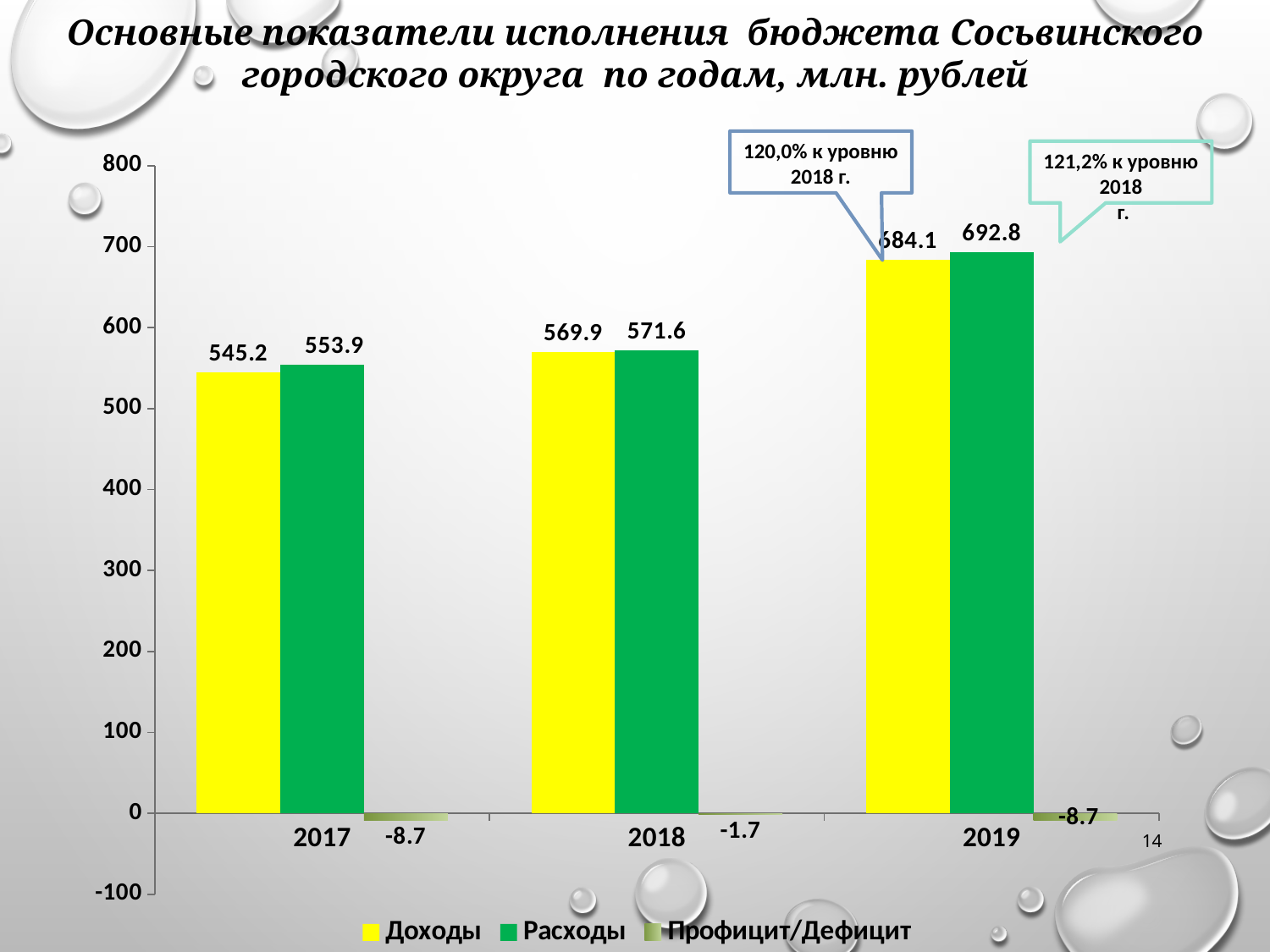
Is the value of Доходы for 2019 greater or less than 600? greater In which year is Расходы the highest? 2019 What is the value of Профицит/Дефицит for 2018? -1.7 Do the Расходы values rise or fall from 2017 to 2019? rise In 2018, which is larger: Доходы or Расходы? Расходы What is the value of Расходы for 2019? 692.8 How many series does the legend list? 3 What is the difference between Расходы and Доходы in 2017? 8.7 What is the value of Доходы for 2017? 545.2 How many years are shown on the x axis? 3 What is the value of Расходы for 2018? 571.6 In which year is Доходы the lowest? 2017